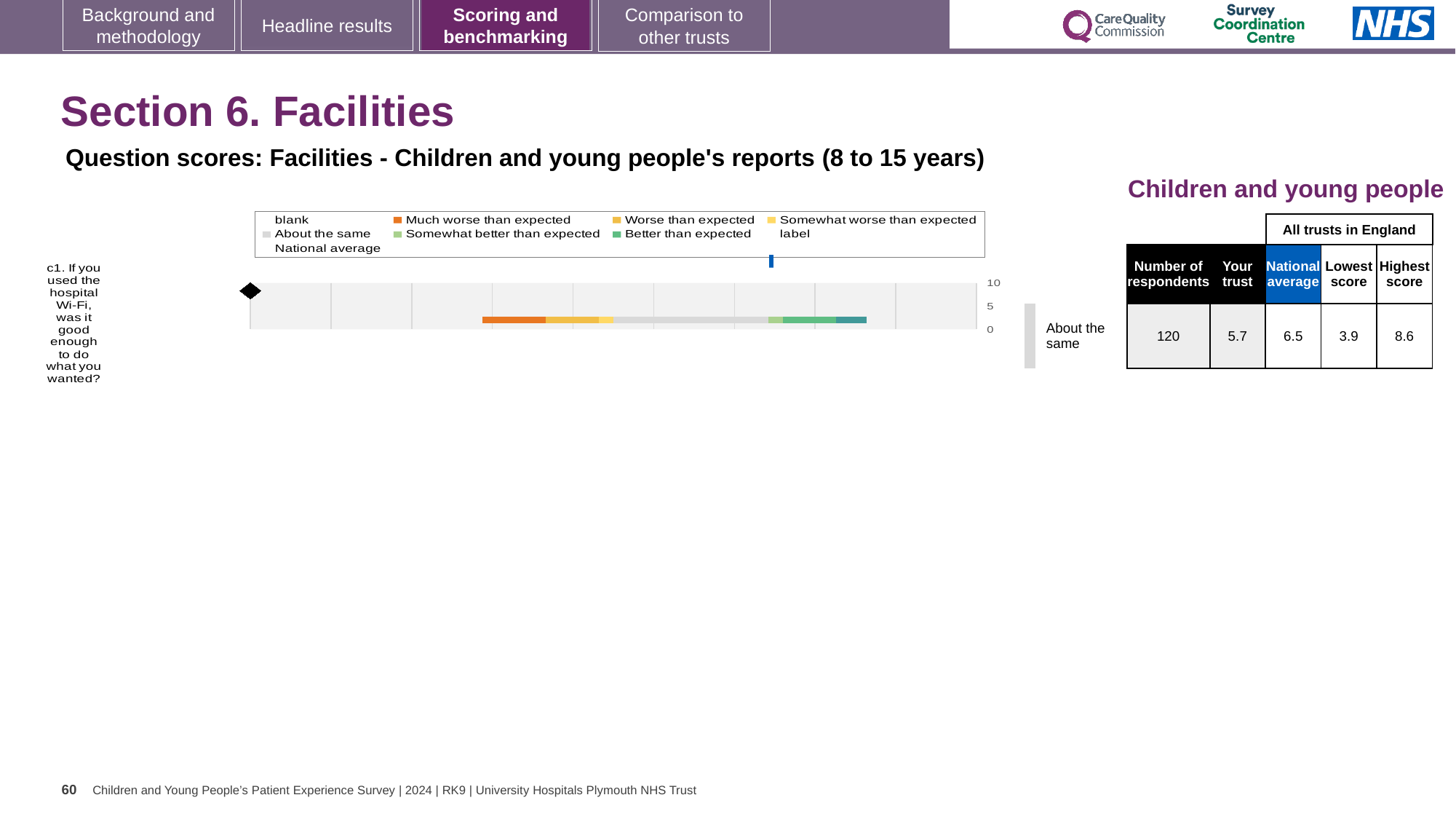
Which is larger for question c1: the 'Your trust' score or the national average? National average What is the national average score for question c1? 6.5 How many respondents answered question c1? 120 By how much does the national average exceed the 'Your trust' score for question c1? 0.8 What is the 'Your trust' score for question c1 about the hospital Wi-Fi? 5.7 How many survey questions are plotted on the chart? 1 Which benchmark category is the trust's result for question c1 labelled as? About the same What is the difference between the highest score and the lowest score for question c1? 4.7 What is the highest value shown on the chart's score axis? 10 What kind of chart is used to show the question score for c1? bar chart What is the highest score among all trusts in England for question c1? 8.6 What is the lowest score among all trusts in England for question c1? 3.9